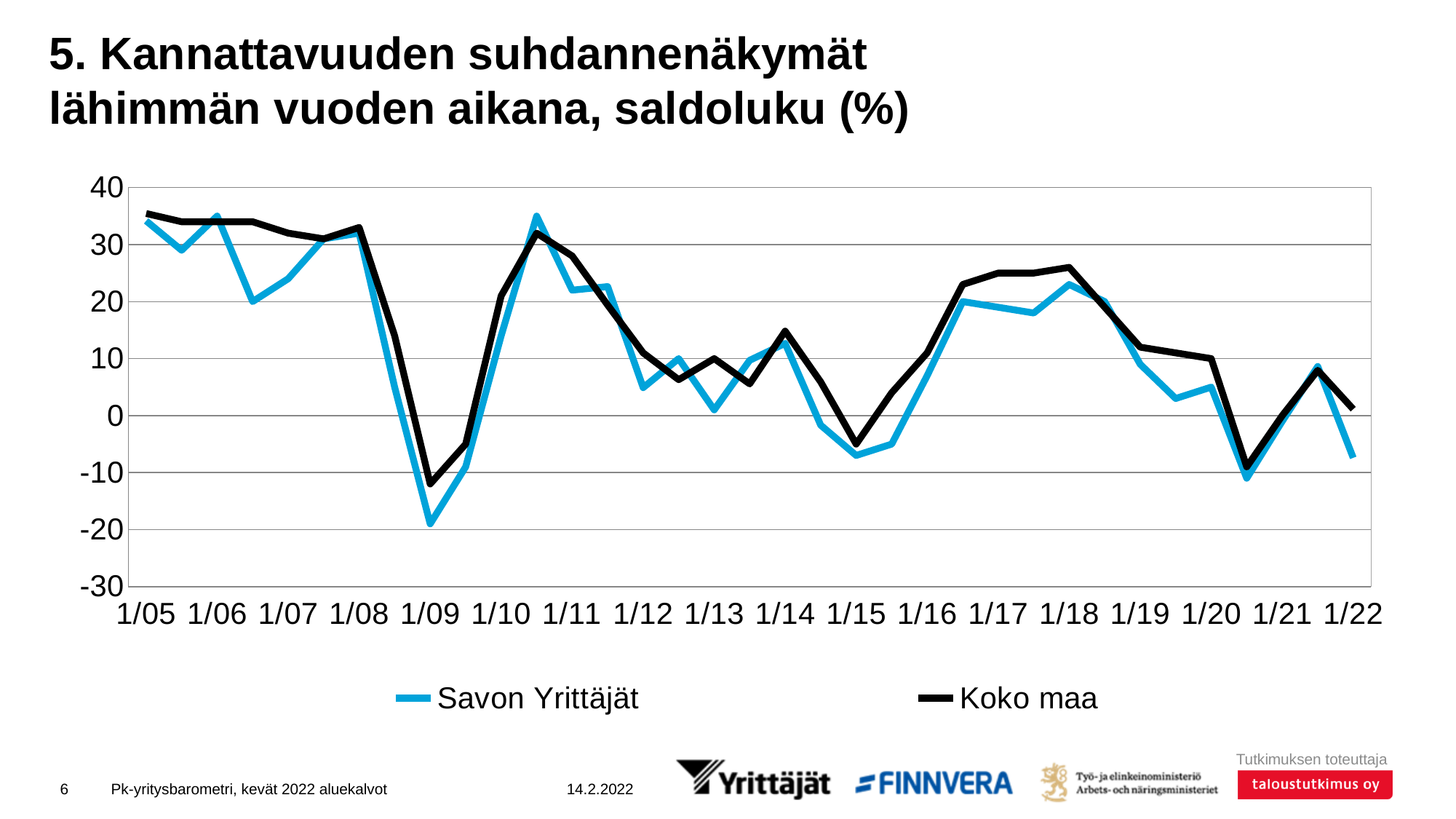
What are the two series named in the legend? Savon Yrittäjät and Koko maa Does the Koko maa line rise or fall between 1/18 and 1/20? fall What kind of chart is shown on the slide? line chart Is the value for Savon Yrittäjät at 1/05 greater or less than 30? greater What colour is the Savon Yrittäjät line? blue Is the value for Koko maa at 1/22 greater or less than 10? less Is the value for Savon Yrittäjät at 1/09 greater or less than -10? less At 1/22, which series has the higher value, Savon Yrittäjät or Koko maa? Koko maa At 1/09, which series has the higher value, Savon Yrittäjät or Koko maa? Koko maa How many series does the legend list? 2 At which x-axis label does the Savon Yrittäjät line reach its lowest value? 1/09